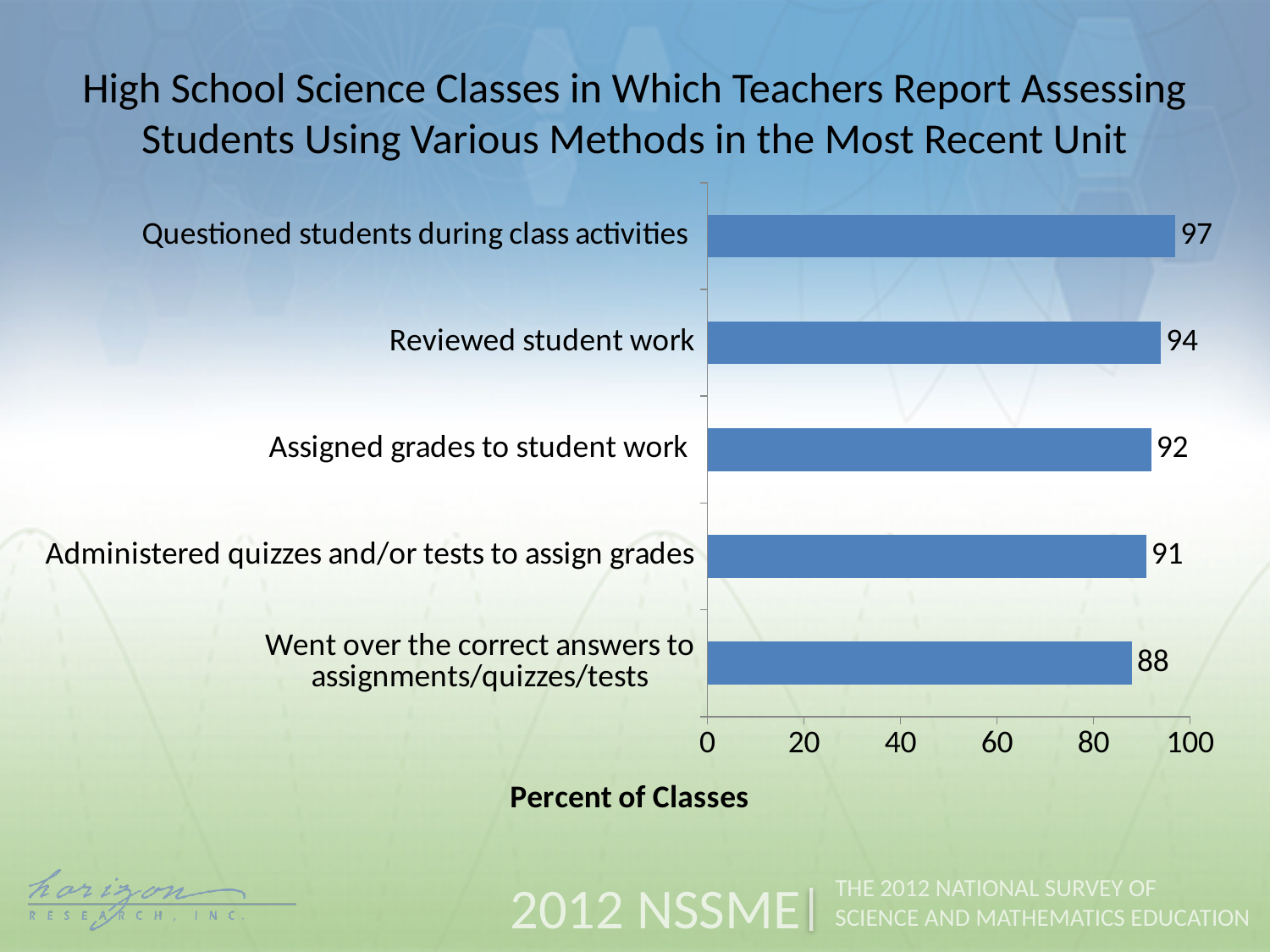
What kind of chart is shown on the slide? Bar chart What percent of classes reported that teachers questioned students during class activities? 97 What is the difference between the values for 'Questioned students during class activities' and 'Went over the correct answers to assignments/quizzes/tests'? 9 Which is larger: the value for 'Assigned grades to student work' or 'Administered quizzes and/or tests to assign grades'? Assigned grades to student work What is the label of the horizontal axis? Percent of Classes What is the value for 'Went over the correct answers to assignments/quizzes/tests'? 88 What is the value for 'Administered quizzes and/or tests to assign grades'? 91 Which assessment method has the highest percent of classes? Questioned students during class activities Which assessment method has the lowest percent of classes? Went over the correct answers to assignments/quizzes/tests What is the value for 'Reviewed student work'? 94 How many assessment methods are shown in the chart? 5 What is the difference between the values for 'Reviewed student work' and 'Assigned grades to student work'? 2